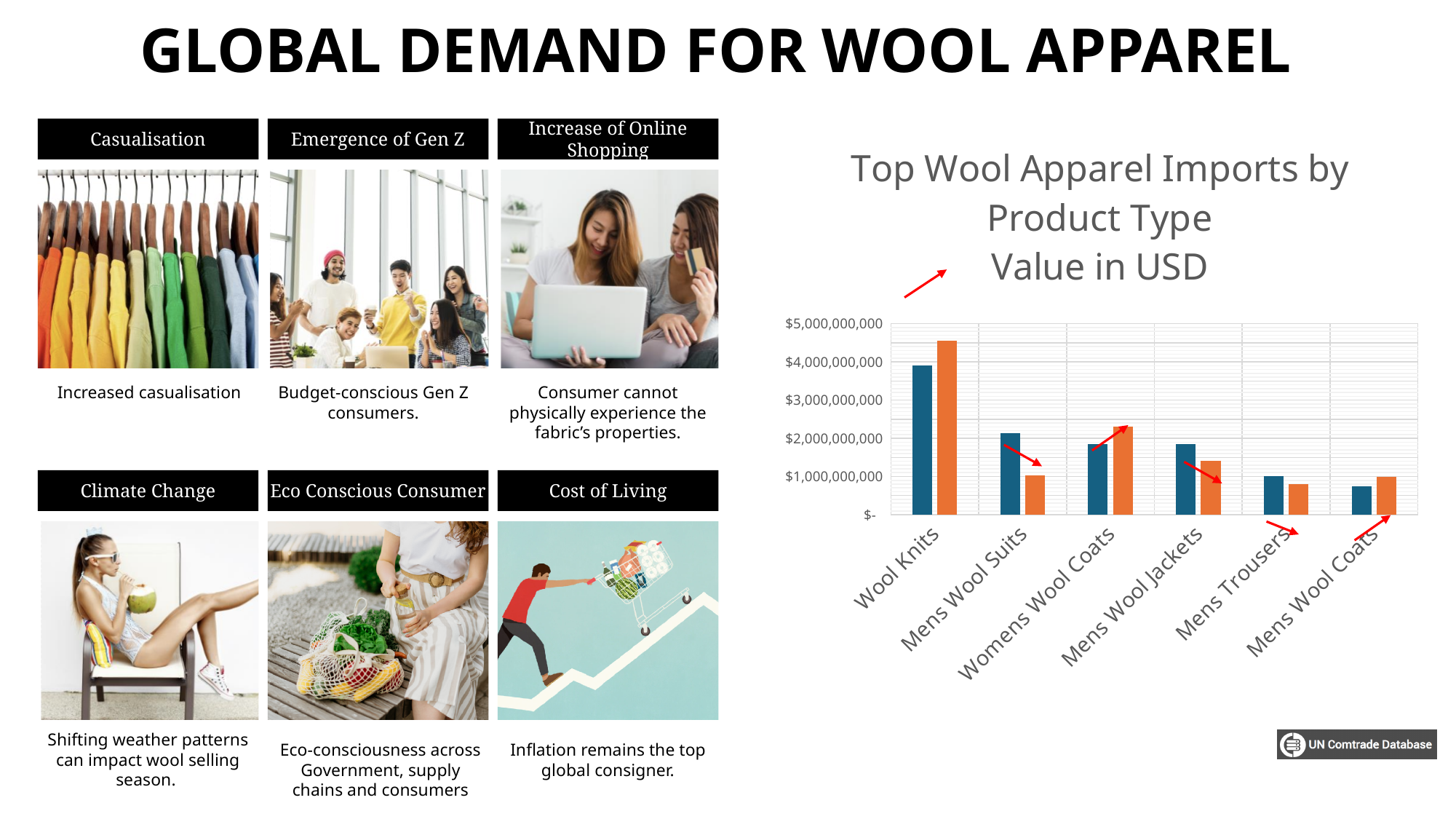
Do the blue bars rise or fall moving from left to right across the categories? Fall Is the orange bar for Mens Wool Suits greater or less than $2,000,000,000? less Is the orange bar for Wool Knits greater or less than $4,000,000,000? greater Which product type has the lowest blue bar in the chart? Mens Wool Coats Is the orange bar for Womens Wool Coats greater or less than $2,000,000,000? greater What kind of chart is shown on the slide? Bar chart For Womens Wool Coats, which bar is larger, the blue bar or the orange bar? The orange bar What is the title of the chart on the slide? Top Wool Apparel Imports by Product Type Value in USD For Mens Wool Suits, which bar is larger, the blue bar or the orange bar? The blue bar How many bars are plotted for each product type category in the chart? 2 How many product type categories are shown on the x axis of the chart? 6 Which product type has the tallest bar in the chart? Wool Knits